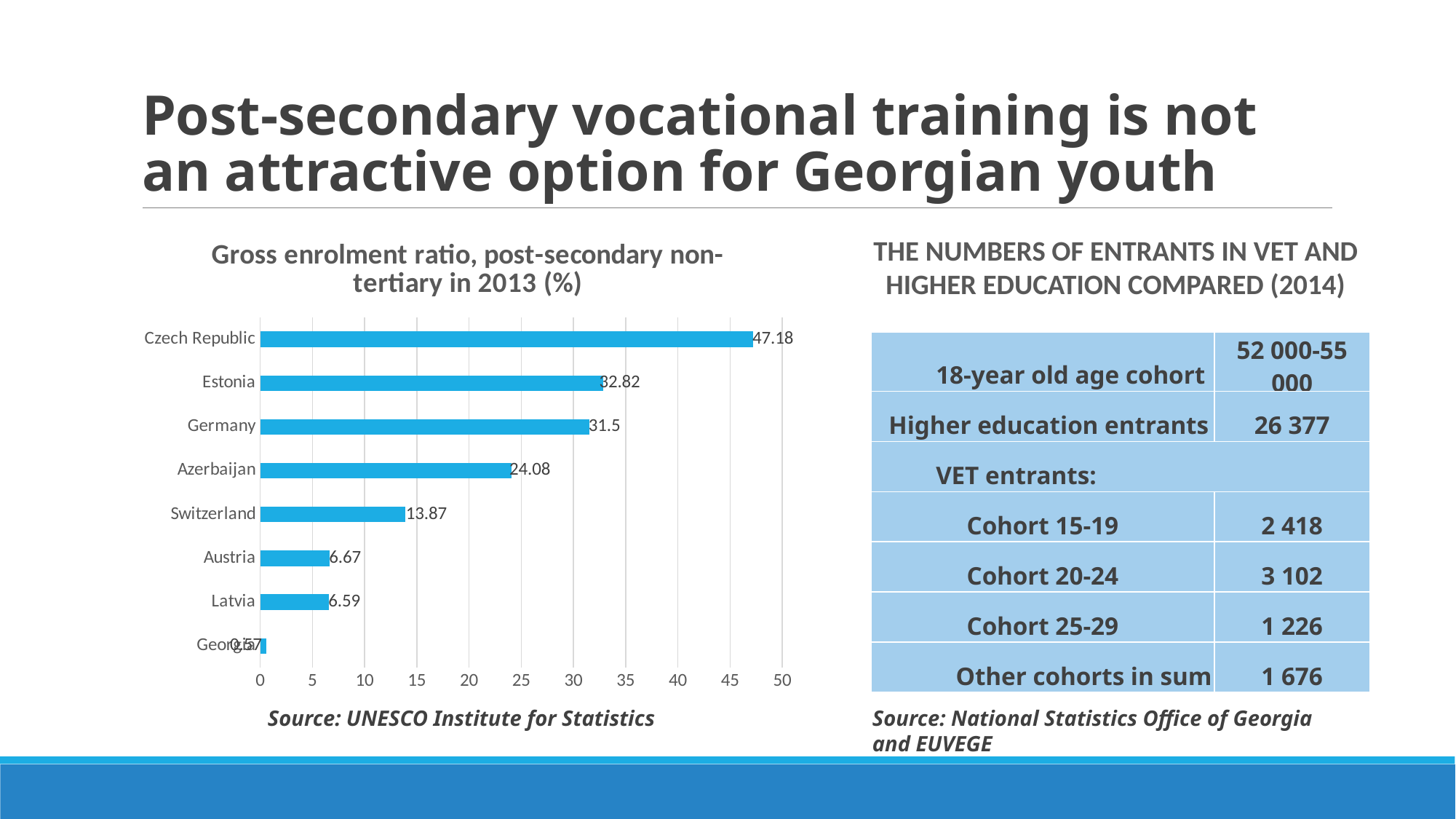
Which country has the highest gross enrolment ratio in the chart? Czech Republic What is the difference between the values for the Czech Republic and Estonia? 14.36 What is the value for Azerbaijan in the chart? 24.08 Which country has the lowest gross enrolment ratio in the chart? Georgia What is the difference between the values for Germany and Azerbaijan? 7.42 Which has a larger value, Germany or Switzerland? Germany What type of chart is used to show the gross enrolment ratio? Bar chart What is the value shown for Switzerland? 13.87 What is the gross enrolment ratio for the Czech Republic in the bar chart? 47.18 Is the value for Azerbaijan greater or less than 20? greater What value is shown for Estonia in the chart? 32.82 How many countries are shown in the bar chart? 8